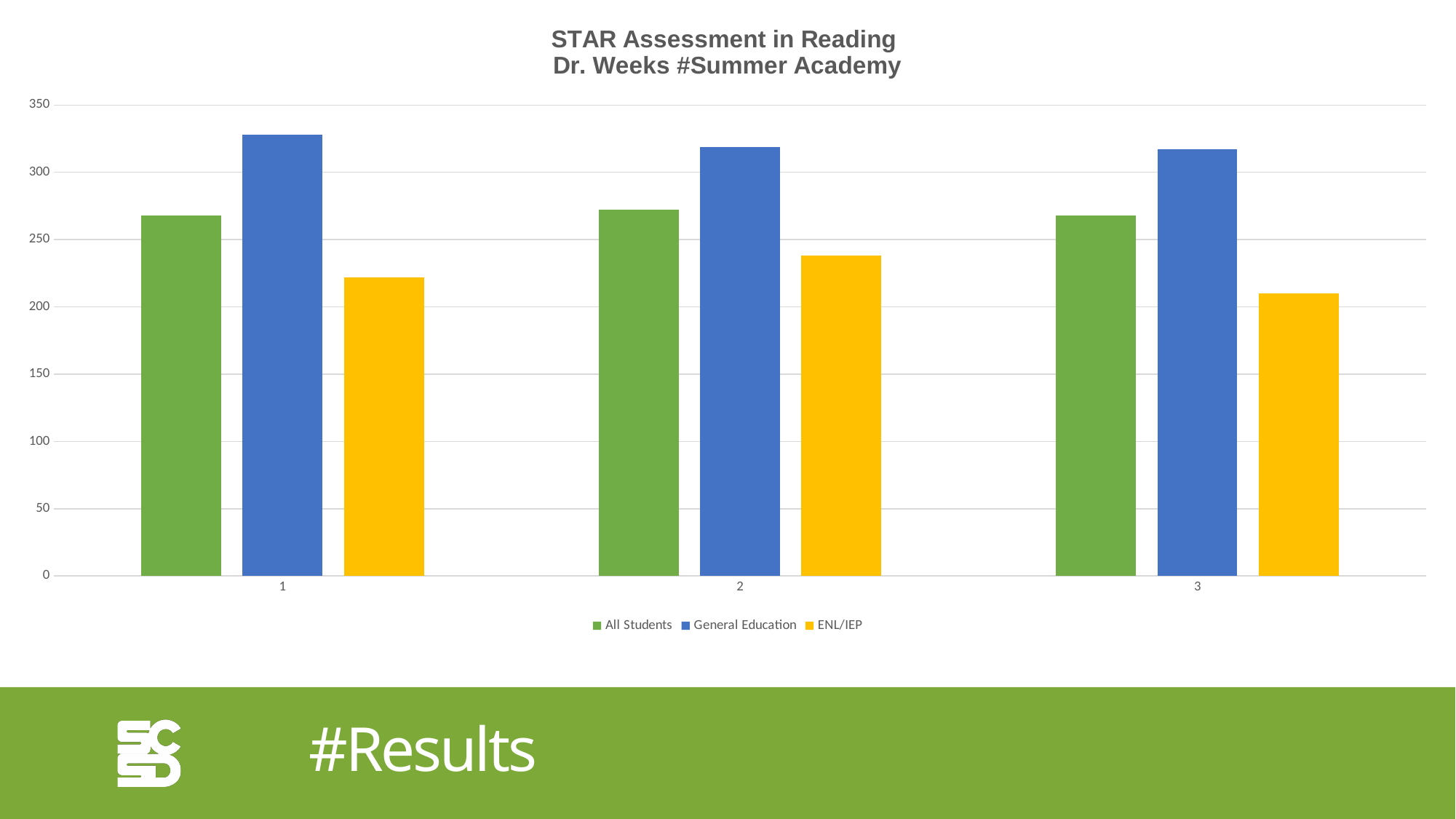
Is the General Education value for category 1 greater or less than 300? greater For category 2, which series has the larger value: General Education or ENL/IEP? General Education For category 3, which series has the smallest value? ENL/IEP How many categories are shown on the x axis? 3 What kind of chart is shown on the slide? bar chart For which category is the ENL/IEP value highest? 2 Is the All Students value for category 2 greater or less than 250? greater Which series is shown in yellow? ENL/IEP How many series does the legend list? 3 Is the ENL/IEP value for category 1 greater or less than 250? less What is the title of the chart? STAR Assessment in Reading Dr. Weeks #Summer Academy